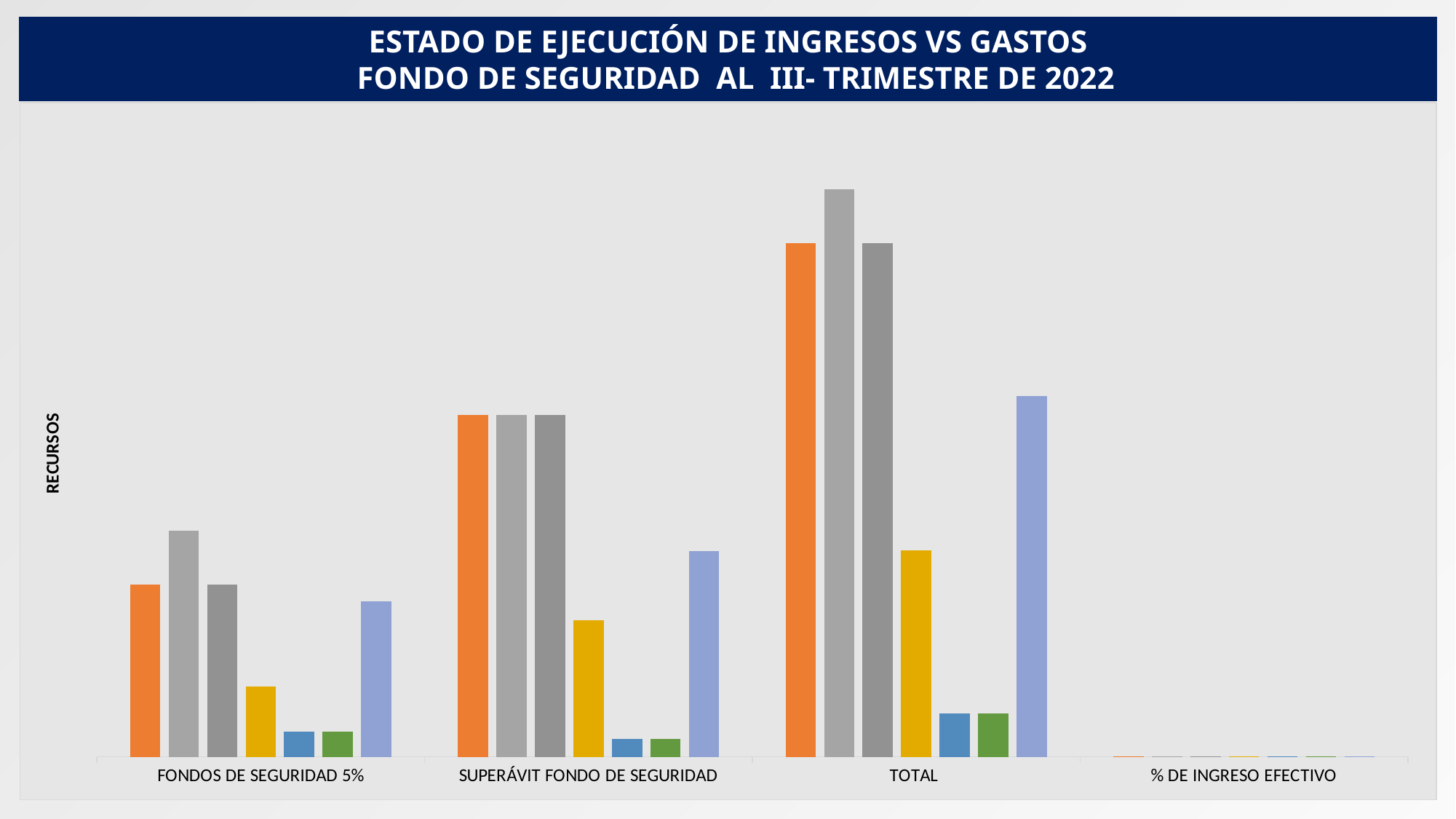
In the TOTAL category, is the light gray bar taller or shorter than the orange bar? Taller What kind of chart is shown on the slide? Bar chart Is the orange bar for TOTAL taller or shorter than the orange bar for FONDOS DE SEGURIDAD 5%? Taller How many categories are shown along the x axis of the chart? 4 How many bars are plotted in each category group of the chart? 7 Which category has the tallest bar in the chart? TOTAL What is the label on the vertical axis of the chart? RECURSOS What is the title of the chart? ESTADO DE EJECUCIÓN DE INGRESOS VS GASTOS FONDO DE SEGURIDAD AL III- TRIMESTRE DE 2022 In the SUPERÁVIT FONDO DE SEGURIDAD category, is the yellow bar taller or shorter than the blue bar? Taller Which category has the smallest bars in the chart? % DE INGRESO EFECTIVO